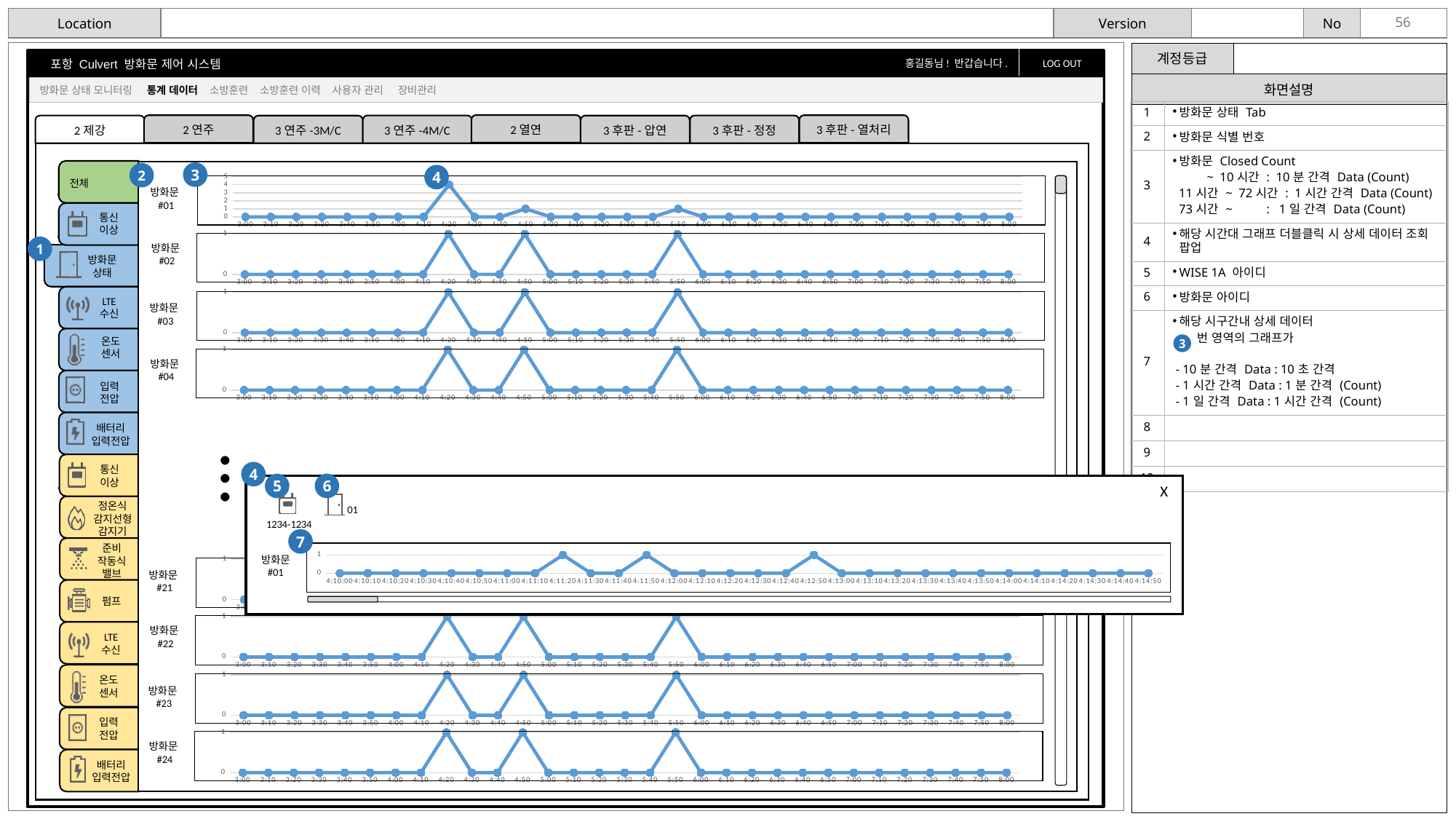
On the 방화문 #01 chart (top chart), which is larger: the value at 4:20 or the value at 4:50? 4:20 On the popup 방화문 #01 chart, at which times does the line rise to 1? 4:11:20, 4:11:50, 4:12:50 On the 방화문 #02 chart, what is the value at 3:00? 0 On the 방화문 #03 chart, how many peaks does the line have? 3 On the 방화문 #01 chart (top chart), what is the highest value shown on the y axis? 5 On the 방화문 #01 chart (top chart), is the value at 4:20 greater or less than 3? greater On the 방화문 #01 chart (top chart), at which time does the line reach its highest point? 4:20 On the 방화문 #02 chart, at which times does the line rise to 1? 4:20, 4:50, 5:50 On the 방화문 #24 chart, what is the first time label on the x axis? 3:00 On the popup 방화문 #01 chart, what is the first time label on the x axis? 4:10:00 On the 방화문 #24 chart, what is the last time label on the x axis? 8:00 What kind of chart is used for the 방화문 #02 graph? line chart